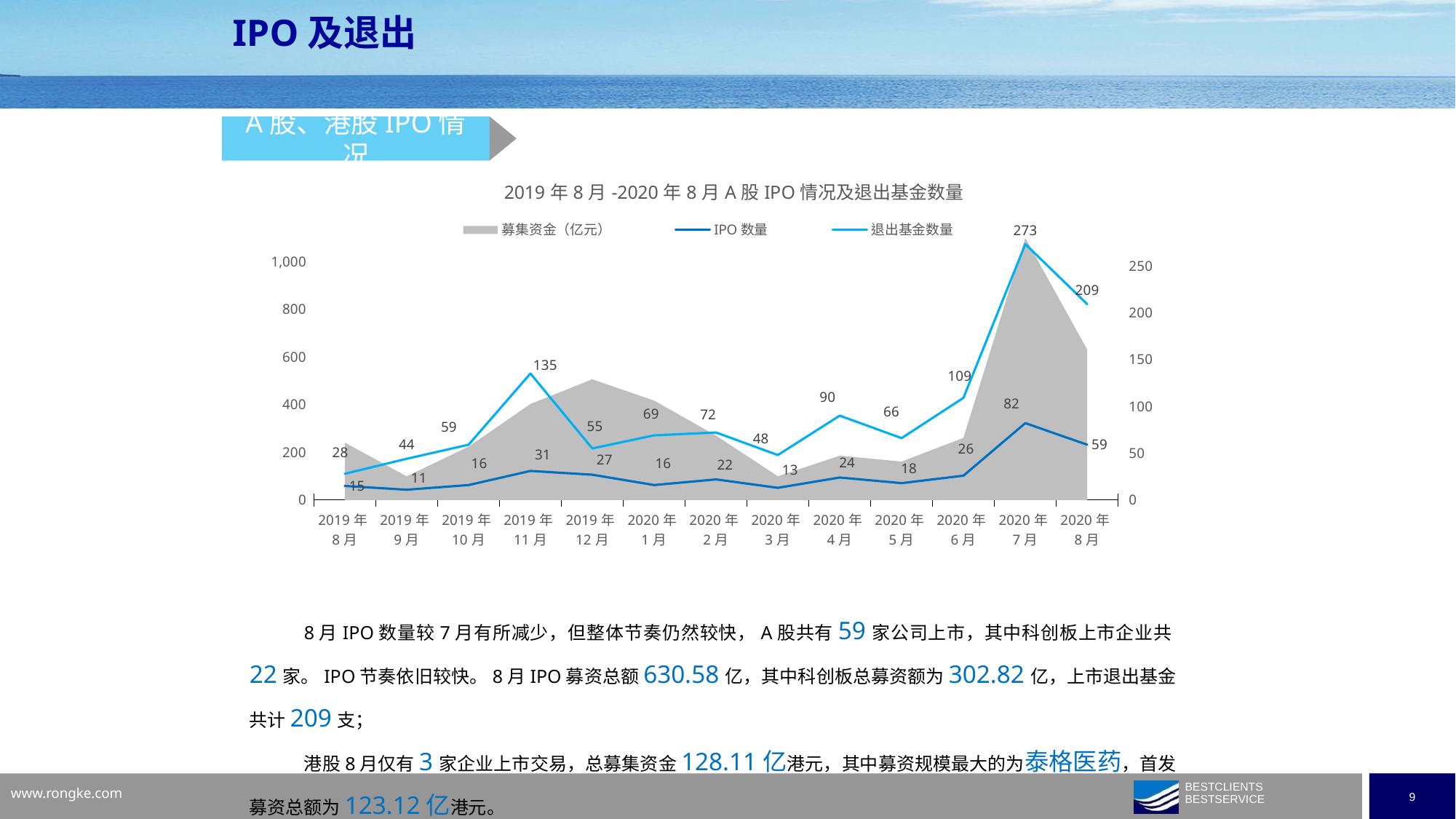
What is the title of the chart? 2019年8月-2020年8月A股IPO情况及退出基金数量 What is the value of IPO数量 for 2020年8月? 59 What is the value of 退出基金数量 for 2019年11月? 135 What is the difference between 退出基金数量 in 2020年7月 and 2020年8月? 64 How many series does the chart legend list? 3 How many months are shown on the x axis of the chart? 13 What is the value of 退出基金数量 for 2020年7月? 273 Which month has the highest 退出基金数量? 2020年7月 Which month has the lowest IPO数量? 2019年9月 What is the value of IPO数量 for 2019年9月? 11 Is the 募集资金（亿元） value for 2020年7月 greater or less than 800? greater Which is larger, IPO数量 in 2020年7月 or in 2020年8月? 2020年7月